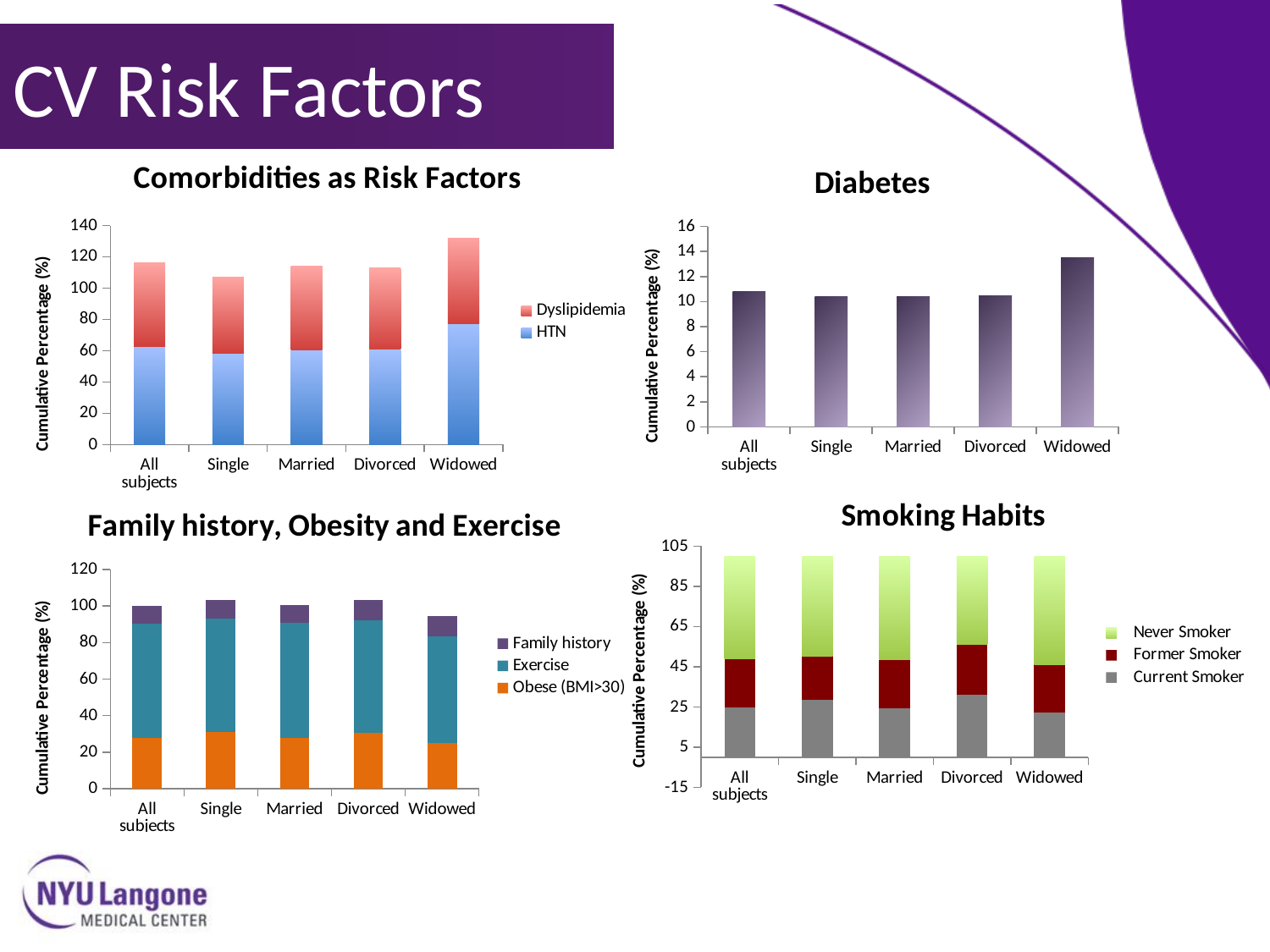
How many series does the legend of the Smoking Habits chart list? 3 In the Diabetes chart, is the value for Widowed greater or less than 12? greater In the Family history, Obesity and Exercise chart, is the Obese (BMI>30) value for Widowed greater or less than 40? less In the Comorbidities as Risk Factors chart, which category has the tallest stacked bar? Widowed In the Comorbidities as Risk Factors chart, which category has the shortest stacked bar? Single In the Diabetes chart, which category has the highest value? Widowed In the Family history, Obesity and Exercise chart, which category has the shortest stacked bar? Widowed How many categories are shown on the x axis of the Diabetes chart? 5 In the Comorbidities as Risk Factors chart, is the HTN value for Widowed greater or less than 60? greater What kind of chart is the Diabetes chart? bar chart How many series does the legend of the Comorbidities as Risk Factors chart list? 2 In the Smoking Habits chart, which series is shown in green? Never Smoker